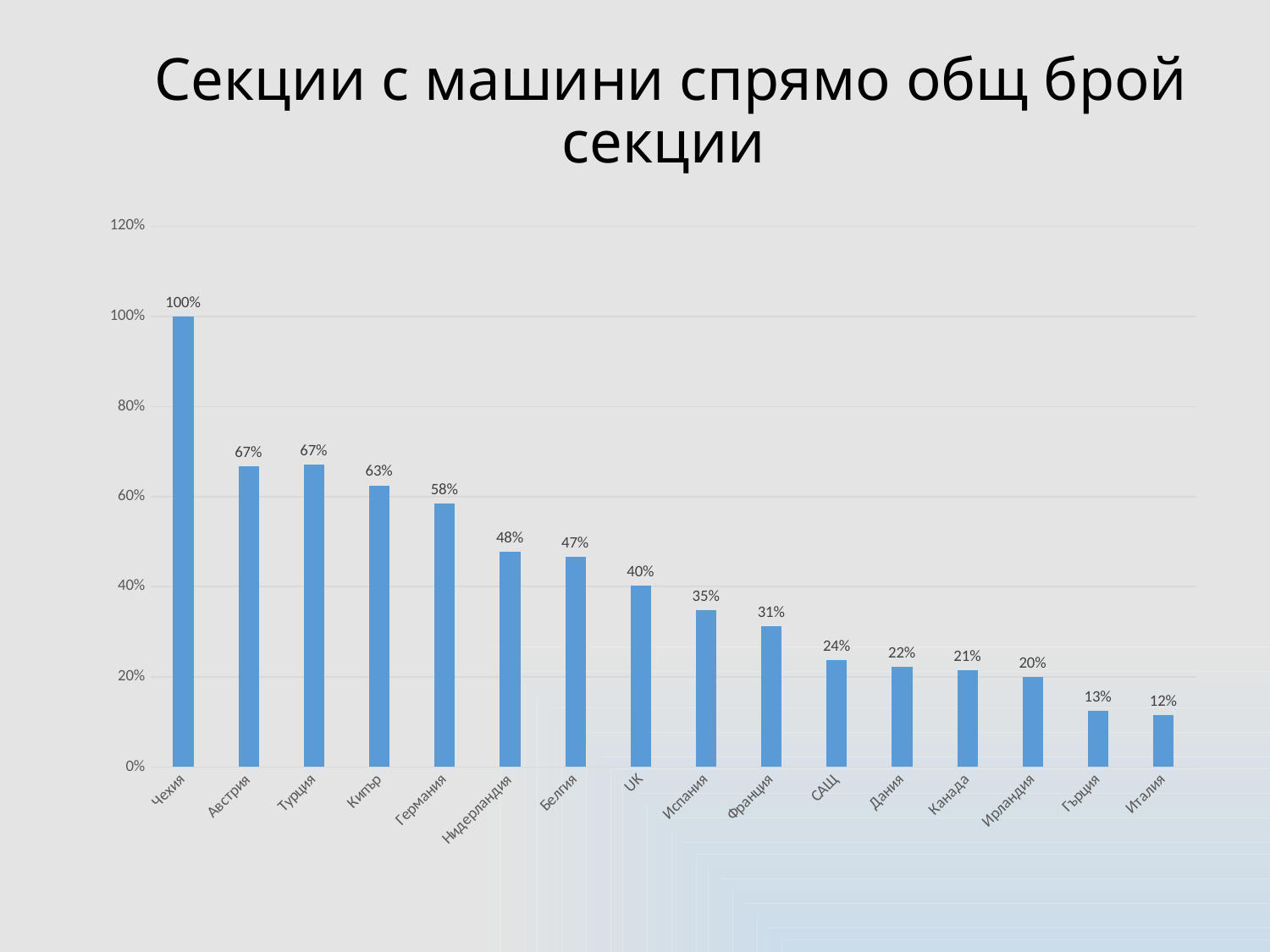
What is the value for UK? 40% Which is larger, the value for Франция or the value for Дания? Франция What is the value for Канада? 21% Which country has the highest value? Чехия What is the difference between the values for Чехия and Кипър? 37% What is the value for Германия? 58% What kind of chart is shown on the slide? bar chart Is the value for Нидерландия greater or less than 40%? greater Which country has the lowest value? Италия How many countries are shown on the chart? 16 What is the difference between the values for Испания and САЩ? 11% Do the values rise or fall from left to right along the x axis? fall